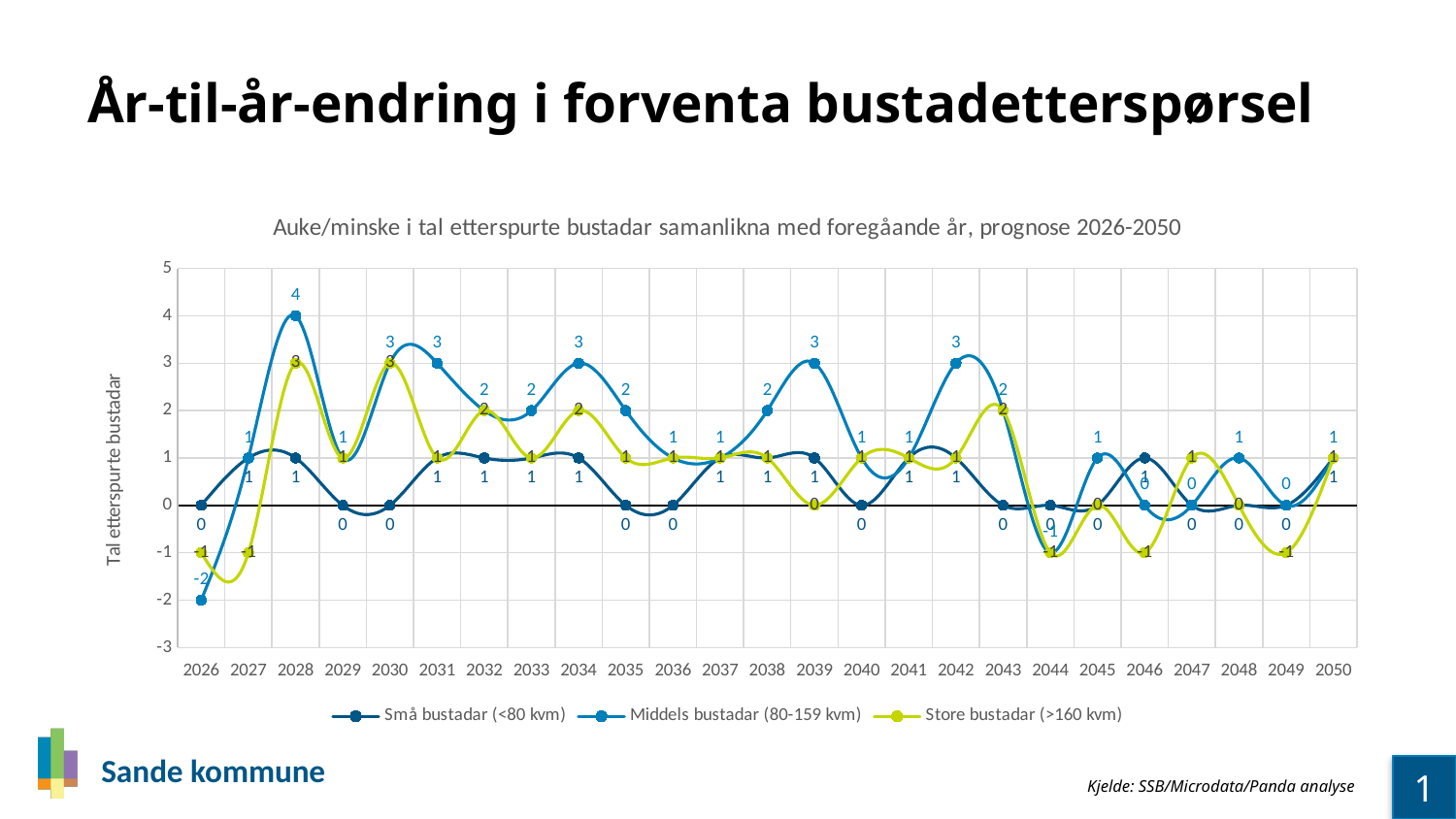
In which year does Middels bustadar (80-159 kvm) have its lowest value? 2026 What kind of chart is shown on the slide? line chart Which series has the larger value in 2028, Middels bustadar (80-159 kvm) or Små bustadar (<80 kvm)? Middels bustadar (80-159 kvm) Does the Middels bustadar (80-159 kvm) series rise or fall from 2026 to 2028? rise What is the difference between Middels bustadar (80-159 kvm) and Små bustadar (<80 kvm) in 2028? 3 What is the value for Middels bustadar (80-159 kvm) in 2028? 4 In which year does Middels bustadar (80-159 kvm) reach its highest value? 2028 How many series does the legend list? 3 What is the value for Store bustadar (>160 kvm) in 2030? 3 How many years are plotted along the x axis? 25 What is the value for Middels bustadar (80-159 kvm) in 2026? -2 What is the chart's title? Auke/minske i tal etterspurte bustadar samanlikna med foregåande år, prognose 2026-2050